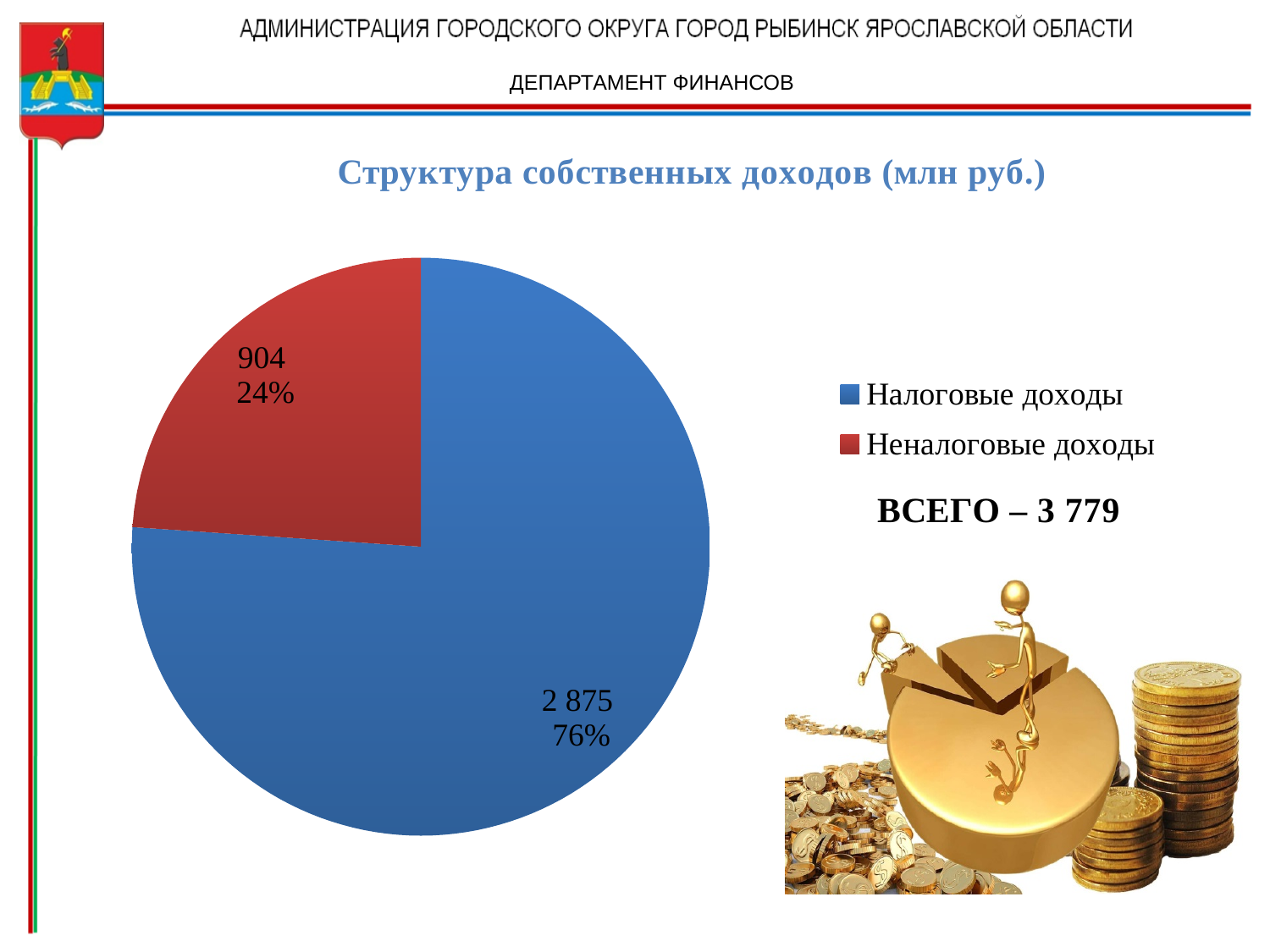
What kind of chart is shown on the slide? pie chart What colour is the slice for Неналоговые доходы? red What share of the pie does Налоговые доходы take? 76% What is the title of the chart? Структура собственных доходов (млн руб.) What is the difference between the values for Налоговые доходы and Неналоговые доходы? 1 971 Which category has the largest slice? Налоговые доходы Which category has the smallest slice? Неналоговые доходы What is the value for Налоговые доходы? 2 875 Which is larger, Налоговые доходы or Неналоговые доходы? Налоговые доходы How many categories does the pie chart have? 2 What is the value for Неналоговые доходы? 904 What share of the pie does Неналоговые доходы take? 24%